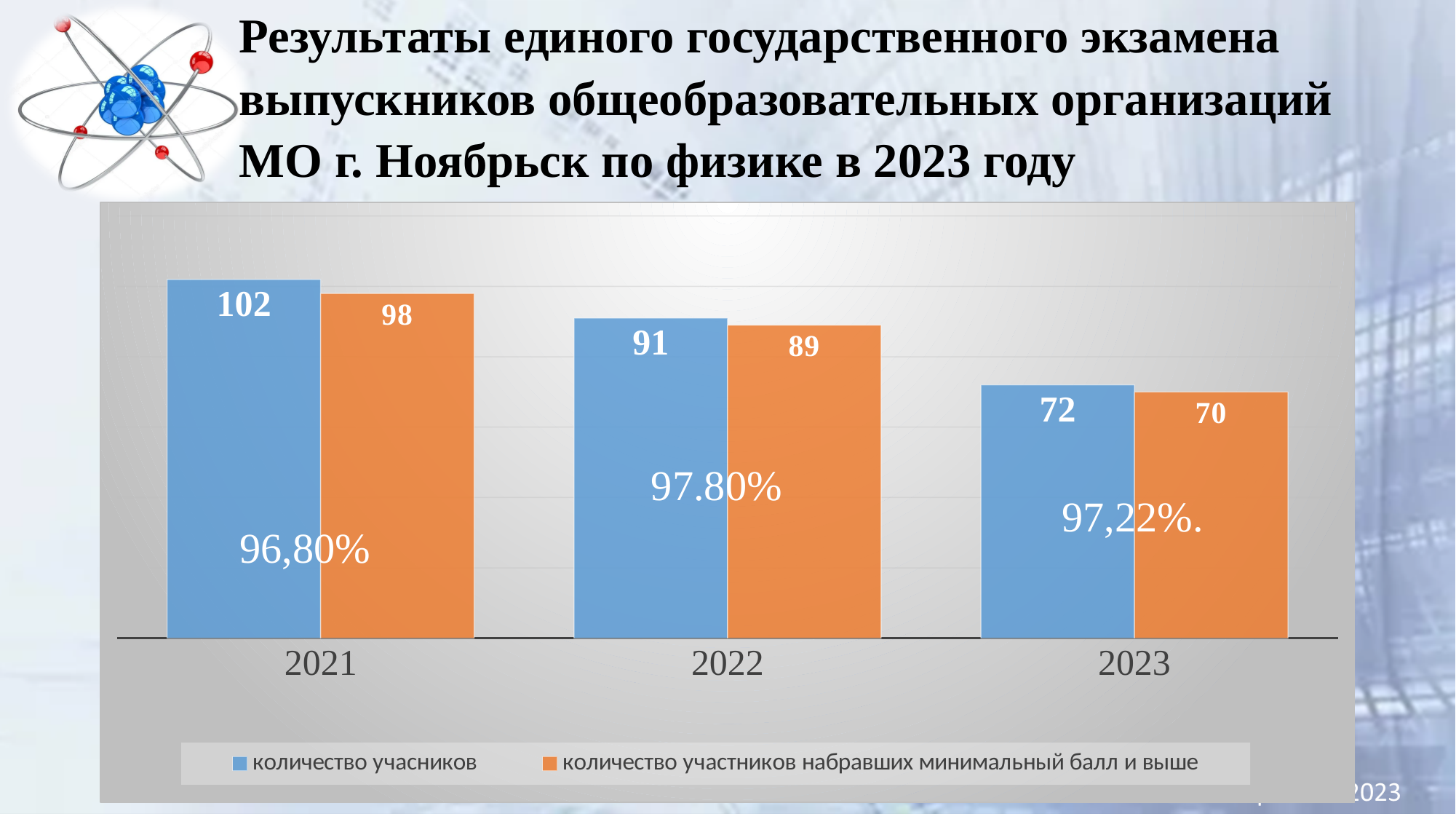
How many series does the legend list? 2 What is the number of participants (количество учасников) in 2023? 72 What is the difference between the number of participants and the number who scored the minimum score or higher in 2021? 4 What is the number of participants (количество учасников) in 2021? 102 What kind of chart is shown on the slide? bar chart What is the number of participants who scored the minimum score or higher in 2022? 89 Does the number of participants rise or fall from 2021 to 2023? fall Which is larger: the number of participants in 2022 or the number who scored the minimum score or higher in 2021? the number who scored the minimum score or higher in 2021 How much did the number of participants fall from 2022 to 2023? 19 Which year has the lowest number of participants who scored the minimum score or higher? 2023 Which year has the highest number of participants? 2021 How many years are shown on the x axis? 3